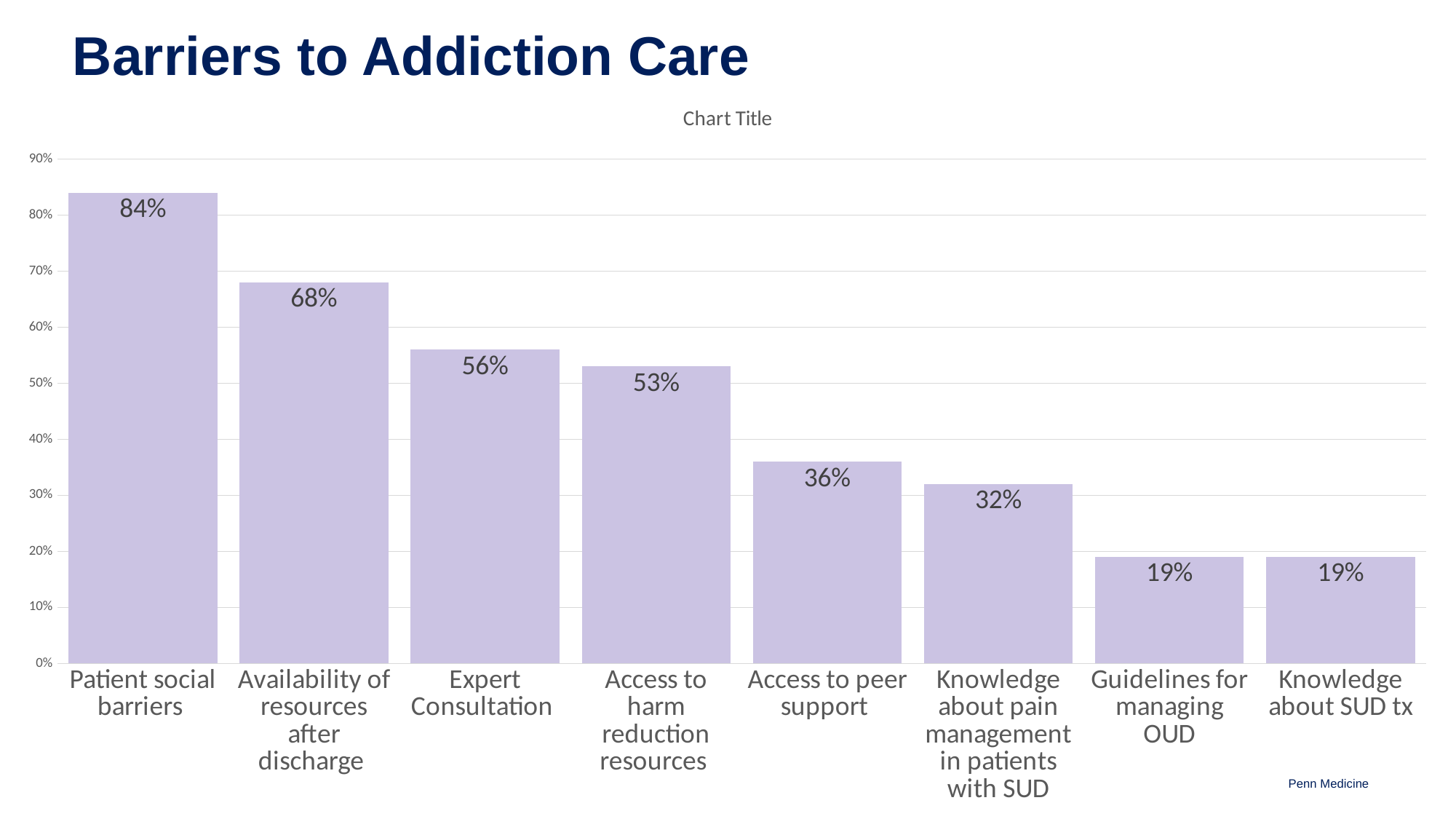
What is the value for Access to harm reduction resources? 53% Which category has the highest value? Patient social barriers Do the values rise or fall from left to right along the x axis? fall What is the value for Patient social barriers? 84% What is the value for Knowledge about pain management in patients with SUD? 32% What is the value for Guidelines for managing OUD? 19% Which is larger, Access to peer support or Knowledge about pain management in patients with SUD? Access to peer support What kind of chart is shown on the slide? bar chart How many categories are shown in the chart? 8 What is the difference between Expert Consultation and Access to peer support? 20% What is the difference between Patient social barriers and Availability of resources after discharge? 16% Is the value for Expert Consultation greater or less than 50%? greater